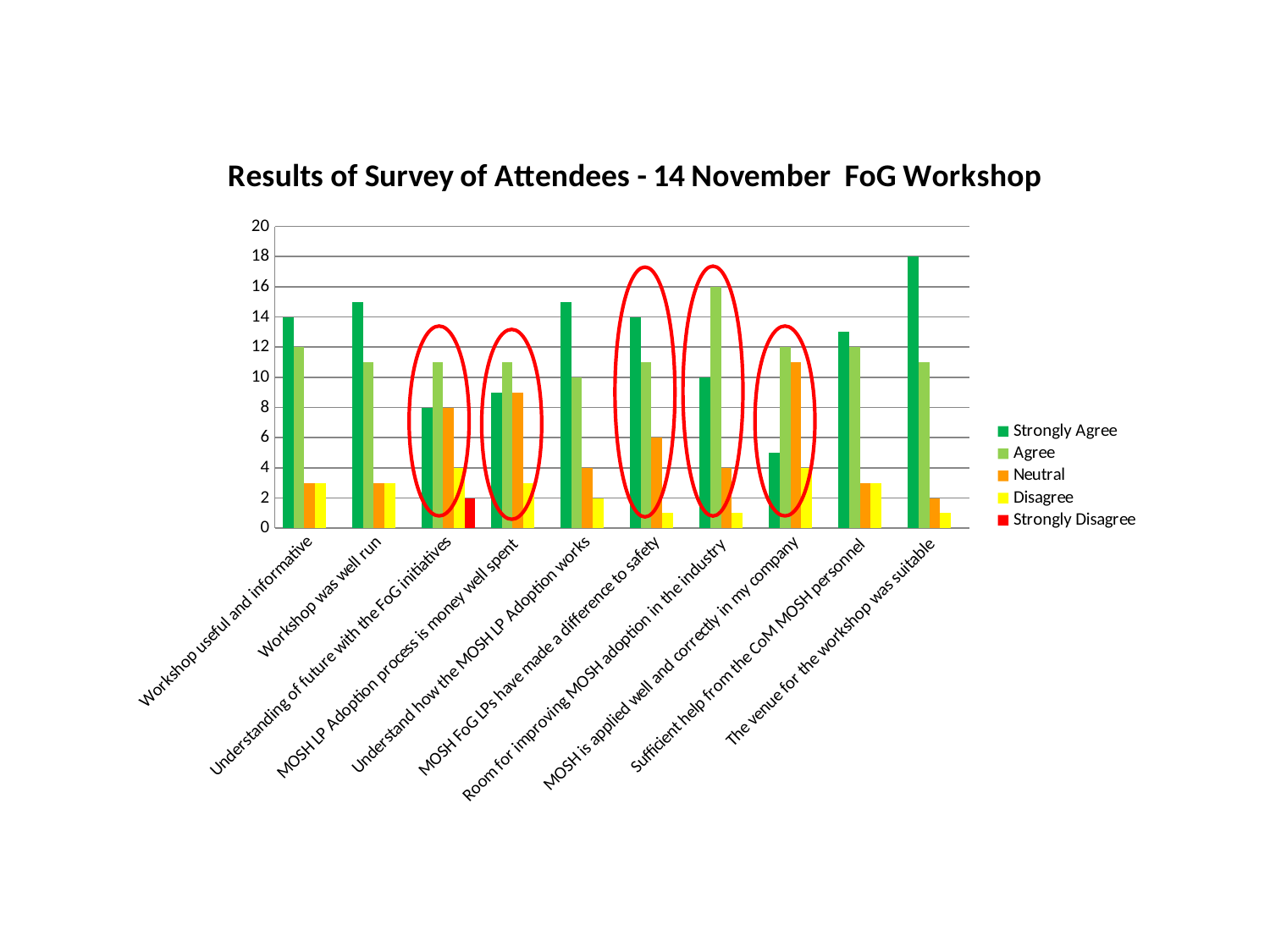
What is the Agree value for 'Room for improving MOSH adoption in the industry'? 16 What is the Strongly Agree value for 'Workshop useful and informative'? 14 What is the title of the chart? Results of Survey of Attendees - 14 November FoG Workshop Is the Strongly Agree value for 'Understand how the MOSH LP Adoption works' greater or less than 12? greater What type of chart is shown on the slide? Bar chart How many survey statements (categories) are shown on the x axis? 10 Which statement has the lowest Strongly Agree value? MOSH is applied well and correctly in my company What is the Strongly Agree value for 'The venue for the workshop was suitable'? 18 Which statement has the highest Strongly Agree value? The venue for the workshop was suitable How many series does the legend list? 5 What is the difference between the Agree value and the Strongly Agree value for 'Room for improving MOSH adoption in the industry'? 6 For 'The venue for the workshop was suitable', which is larger: Strongly Agree or Agree? Strongly Agree